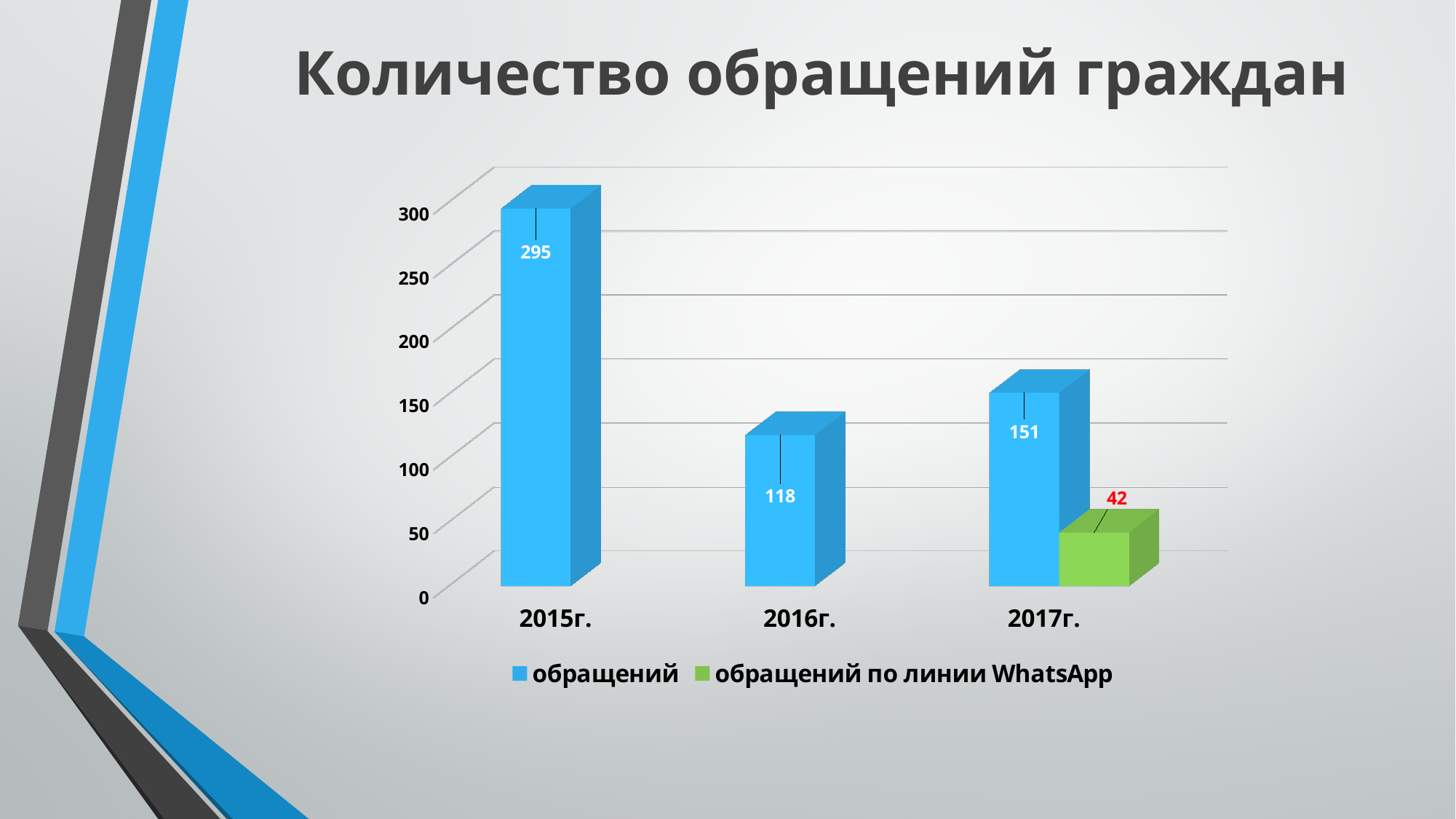
Which year has the lowest value of обращений? 2016г. What is the value of обращений for 2017г.? 151 What is the value of обращений for 2015г.? 295 What is the difference between обращений and обращений по линии WhatsApp in 2017г.? 109 Which is larger: обращений in 2016г. or in 2017г.? 2017г. What is the value of обращений по линии WhatsApp for 2017г.? 42 What kind of chart is shown on the slide? Bar chart How many years are shown on the x axis? 3 What is the value of обращений for 2016г.? 118 Which year has the highest value of обращений? 2015г. What is the difference between обращений in 2015г. and 2016г.? 177 How many series does the legend list? 2